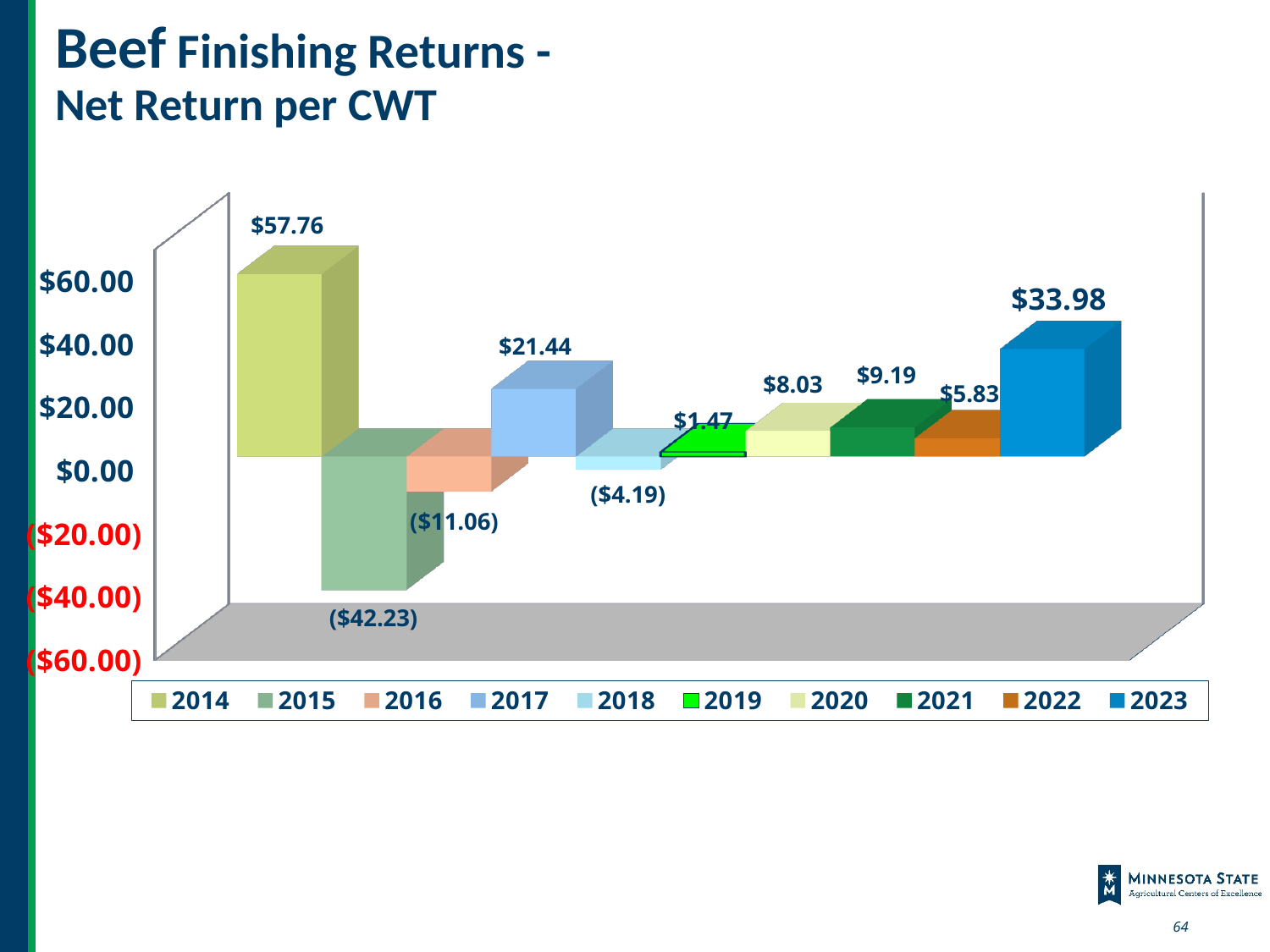
What is the net return per CWT for 2023? $33.98 How many entries does the legend list? 10 How many years are shown in the chart? 10 What is the net return per CWT for 2015? ($42.23) Which year has a larger net return per CWT, 2020 or 2021? 2021 What is the net return per CWT for 2018? ($4.19) What is the difference between the net return per CWT in 2023 and in 2017? $12.54 What is the title of the chart on the slide? Beef Finishing Returns - Net Return per CWT What is the net return per CWT for 2014? $57.76 Which year has the lowest net return per CWT? 2015 What kind of chart is shown on the slide? Bar chart Which year has the highest net return per CWT? 2014